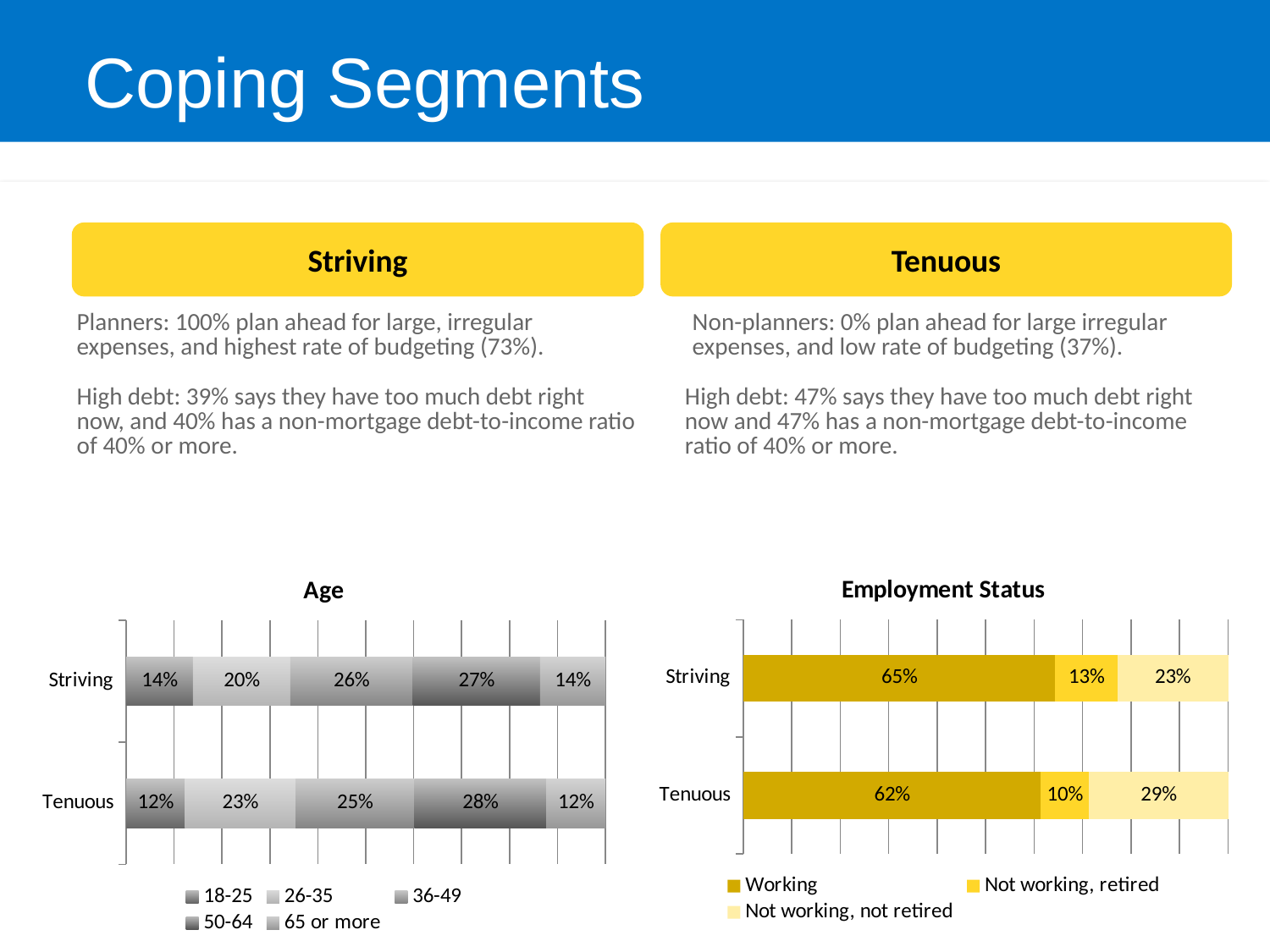
In the Age chart, which age group is the largest share of the Striving segment? 50-64 In the Employment Status chart, what is the total of the Tenuous bar? 101% In the Employment Status chart, which segment has the larger share of people not working, not retired? Tenuous In the Employment Status chart, what percentage of the Striving segment is not working, retired? 13% In the Age chart, how many series does the legend list? 5 In the Age chart, what percentage of the Tenuous segment is aged 50-64? 28% In the Age chart, what percentage of the Striving segment is aged 36-49? 26% In the Employment Status chart, how many categories are shown on the vertical axis? 2 In the Age chart, what is the difference between the 26-35 shares of Tenuous and Striving? 3% What kind of chart is the Employment Status chart? Stacked bar chart In the Employment Status chart, what percentage of the Tenuous segment is working? 62% In the Employment Status chart, what is the difference between the Working shares of Striving and Tenuous? 3%